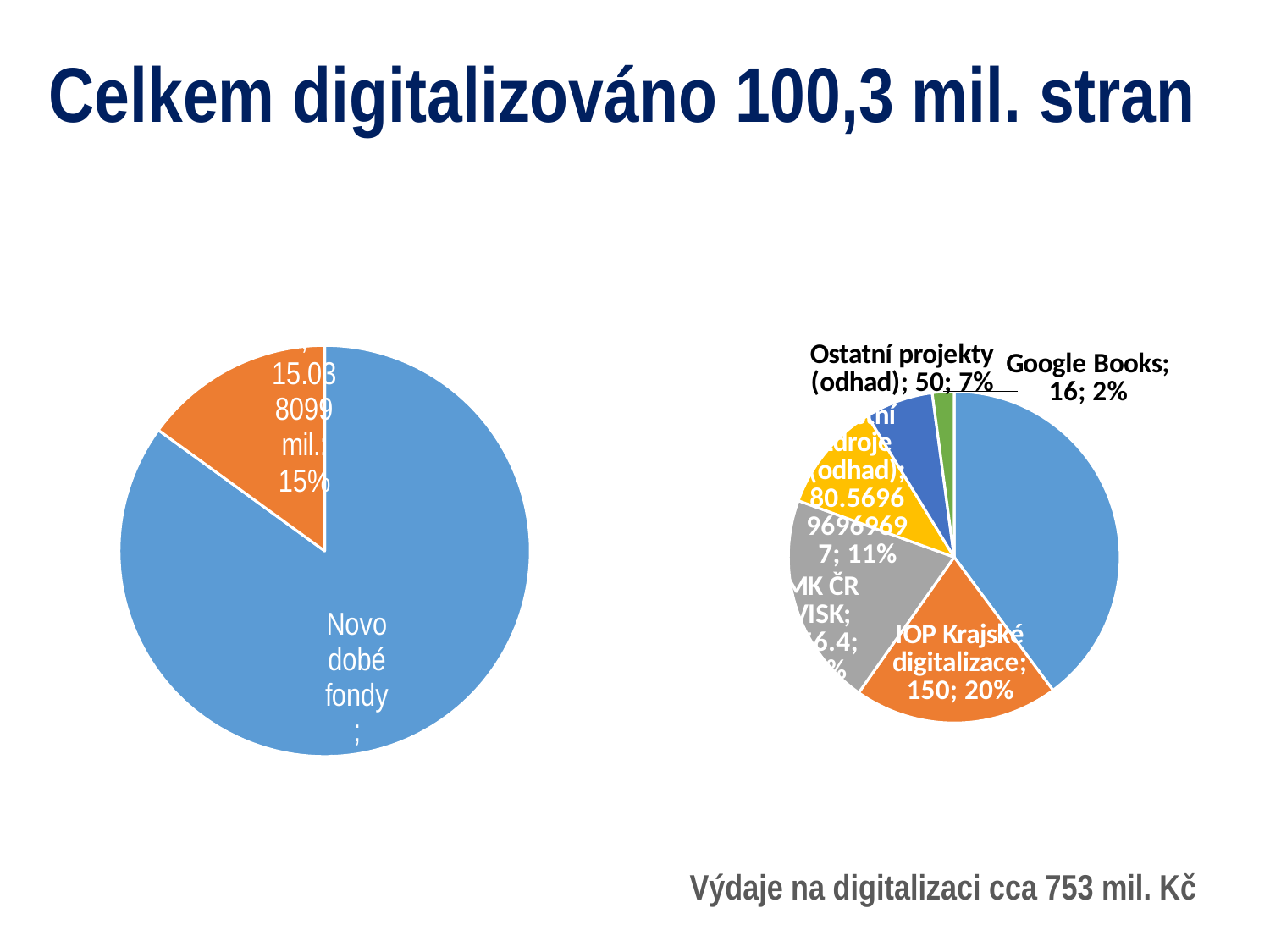
In the left pie chart, what percentage share does the orange slice have? 15% In the right pie chart, what percentage share does Google Books have? 2% What type of chart is the chart on the left of the slide? pie chart In the right pie chart, what is the value for IOP Krajské digitalizace? 150 In the right pie chart, what is the value for Ostatní projekty (odhad)? 50 In the left pie chart, how many slices are there? 2 What type of chart is the chart on the right of the slide? pie chart In the right pie chart, what is the value for Google Books? 16 In the right pie chart, which is larger: IOP Krajské digitalizace or Ostatní projekty (odhad)? IOP Krajské digitalizace In the left pie chart, which slice is the largest? Novodobé fondy What is the title of the slide? Celkem digitalizováno 100,3 mil. stran In the right pie chart, what is the difference between the values for IOP Krajské digitalizace and Ostatní projekty (odhad)? 100